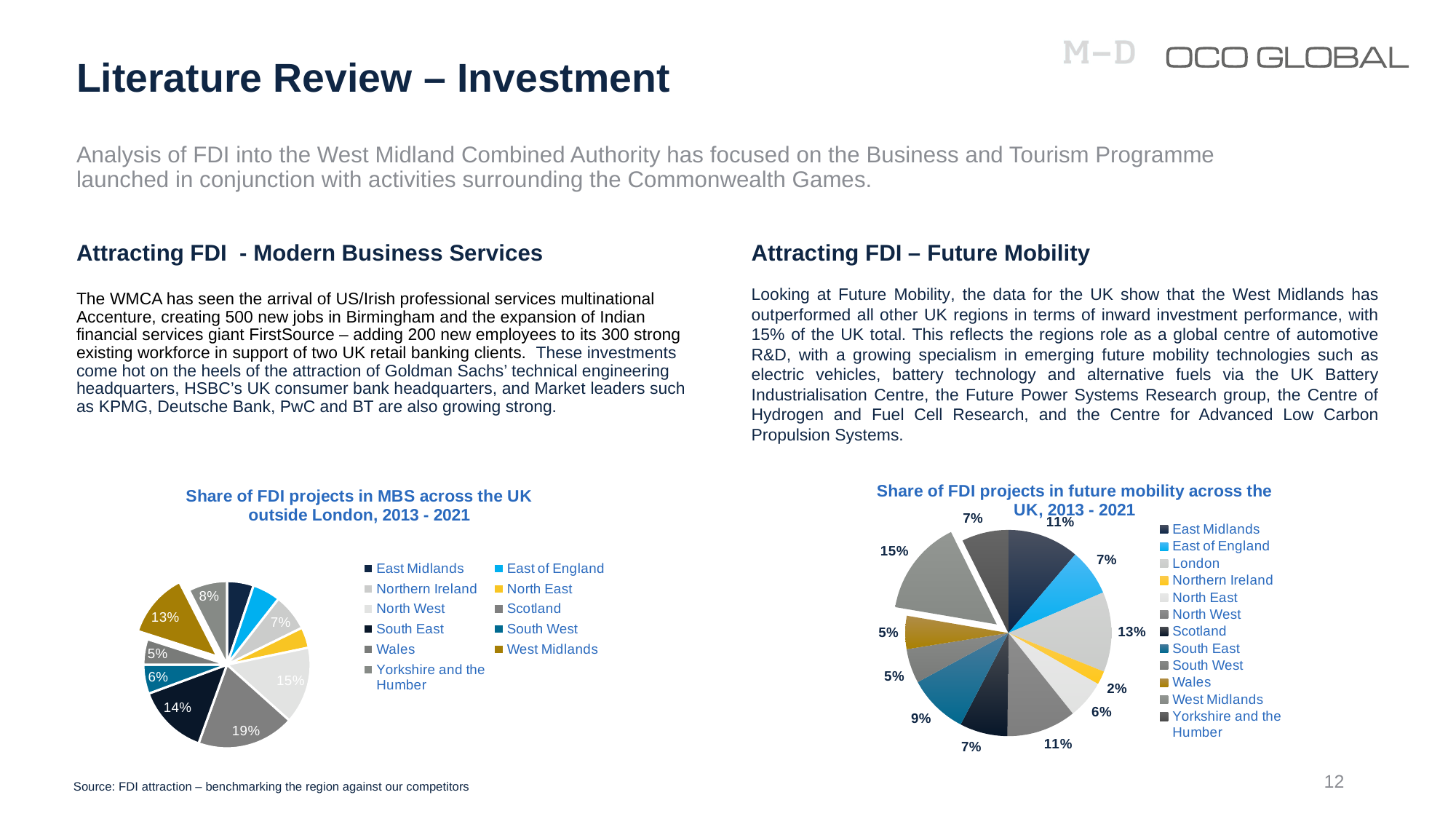
On the 'Share of FDI projects in future mobility across the UK, 2013 - 2021' chart, what share does Northern Ireland have? 2% On the 'Share of FDI projects in future mobility across the UK, 2013 - 2021' chart, which region has the largest share? West Midlands On the 'Share of FDI projects in future mobility across the UK, 2013 - 2021' chart, what share does London have? 13% What type of chart is the 'Share of FDI projects in MBS across the UK outside London, 2013 - 2021' chart? Pie chart On the 'Share of FDI projects in MBS across the UK outside London, 2013 - 2021' chart, what share does the West Midlands have? 13% What is the largest share labelled on the 'Share of FDI projects in MBS across the UK outside London, 2013 - 2021' chart? 19% How many regions does the legend of the 'Share of FDI projects in future mobility across the UK, 2013 - 2021' chart list? 12 On the 'Share of FDI projects in future mobility across the UK, 2013 - 2021' chart, which is larger: East Midlands or South East? East Midlands On the 'Share of FDI projects in future mobility across the UK, 2013 - 2021' chart, how many percentage points larger is the West Midlands share than London's? 2 percentage points On the 'Share of FDI projects in future mobility across the UK, 2013 - 2021' chart, what share does the West Midlands have? 15% How many regions does the legend of the 'Share of FDI projects in MBS across the UK outside London, 2013 - 2021' chart list? 11 On the 'Share of FDI projects in future mobility across the UK, 2013 - 2021' chart, which region has the smallest share? Northern Ireland